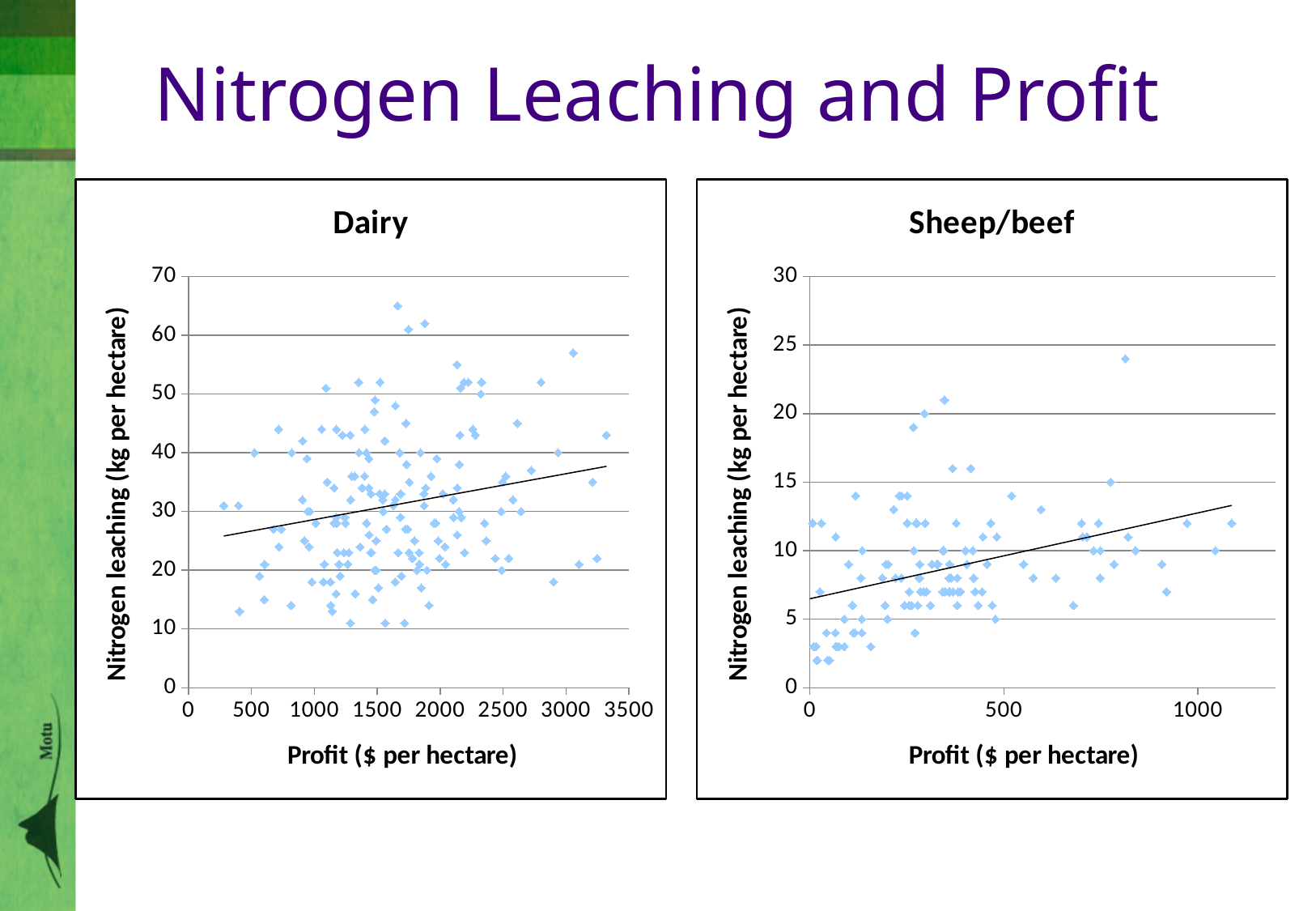
How many charts are shown on the slide? 2 In the Dairy chart, is the highest nitrogen leaching value plotted greater or less than 60? greater What is the x-axis label of the Sheep/beef chart? Profit ($ per hectare) Which chart has the higher maximum value on its y axis, Dairy or Sheep/beef? Dairy What is the y-axis label of the Dairy chart? Nitrogen leaching (kg per hectare) In the Sheep/beef chart, is the lowest nitrogen leaching value plotted greater or less than 5? less In the Sheep/beef chart, is the highest nitrogen leaching value plotted greater or less than 20? greater What kind of chart is the Dairy chart? scatter chart In the Sheep/beef chart, does the fitted trend line rise or fall as profit increases? rise In the Dairy chart, does the fitted trend line rise or fall as profit increases? rise